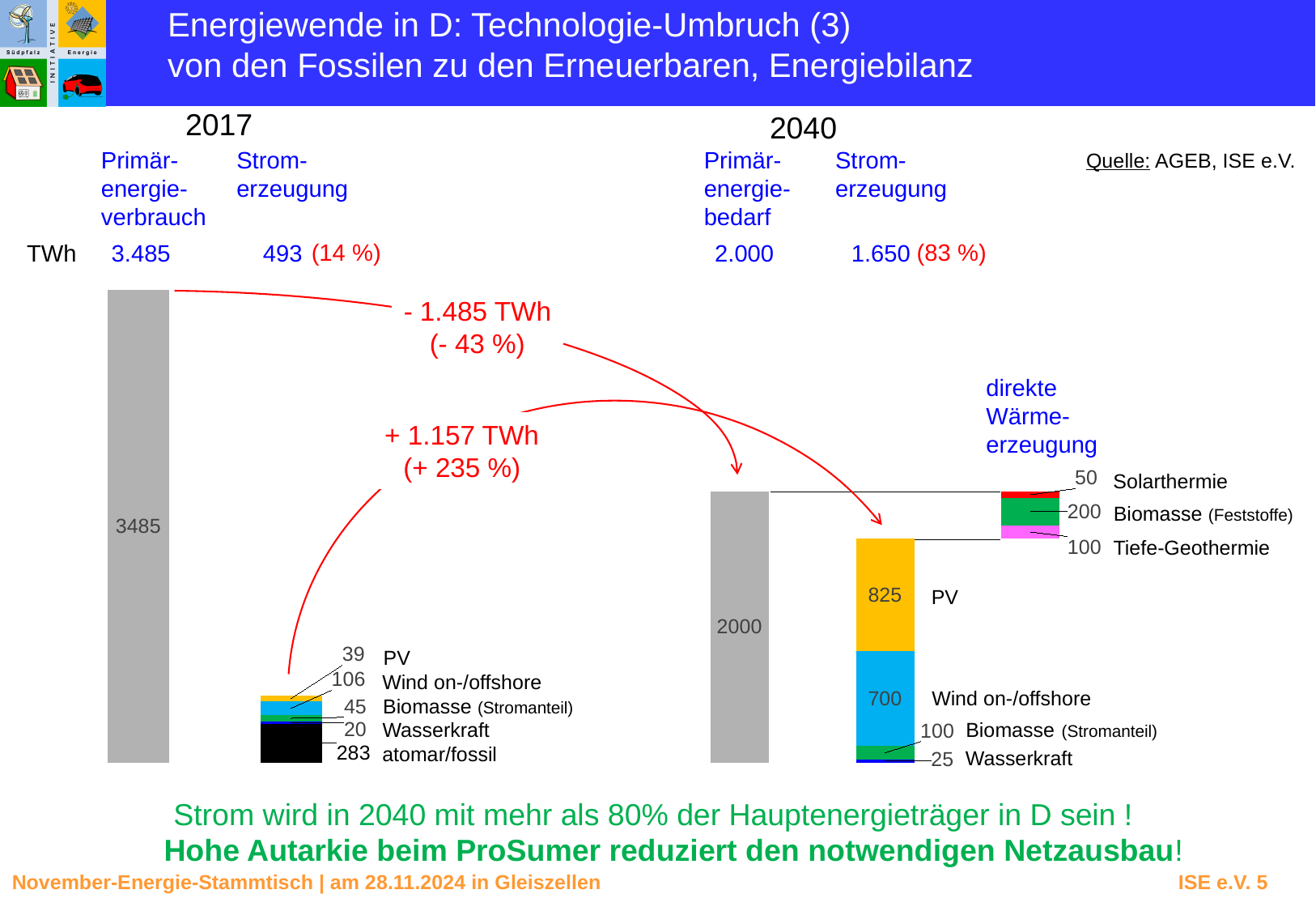
In 2040, which is larger: PV or Wind on-/offshore? PV What value is printed on the 2040 Primärenergiebedarf bar? 2000 In the 2017 Stromerzeugung bar, which segment is the largest? atomar/fossil In the 2040 Stromerzeugung bar, what is the value for PV? 825 How many segments does the 2017 Stromerzeugung bar have? 5 In the 2040 direkte Wärmeerzeugung bar, what is the value for Tiefe-Geothermie? 100 In the 2040 Stromerzeugung bar, which segment is the smallest? Wasserkraft By how much does Wind on-/offshore in 2040 exceed Wind on-/offshore in 2017? 594 In the 2040 Stromerzeugung bar, which segment is the largest? PV What is the total of the 2040 direkte Wärmeerzeugung bar (Solarthermie, Biomasse, Tiefe Geothermie)? 350 In the 2017 Stromerzeugung bar, what is the value for Wind on-/offshore? 106 What kind of chart is used on this slide? bar chart